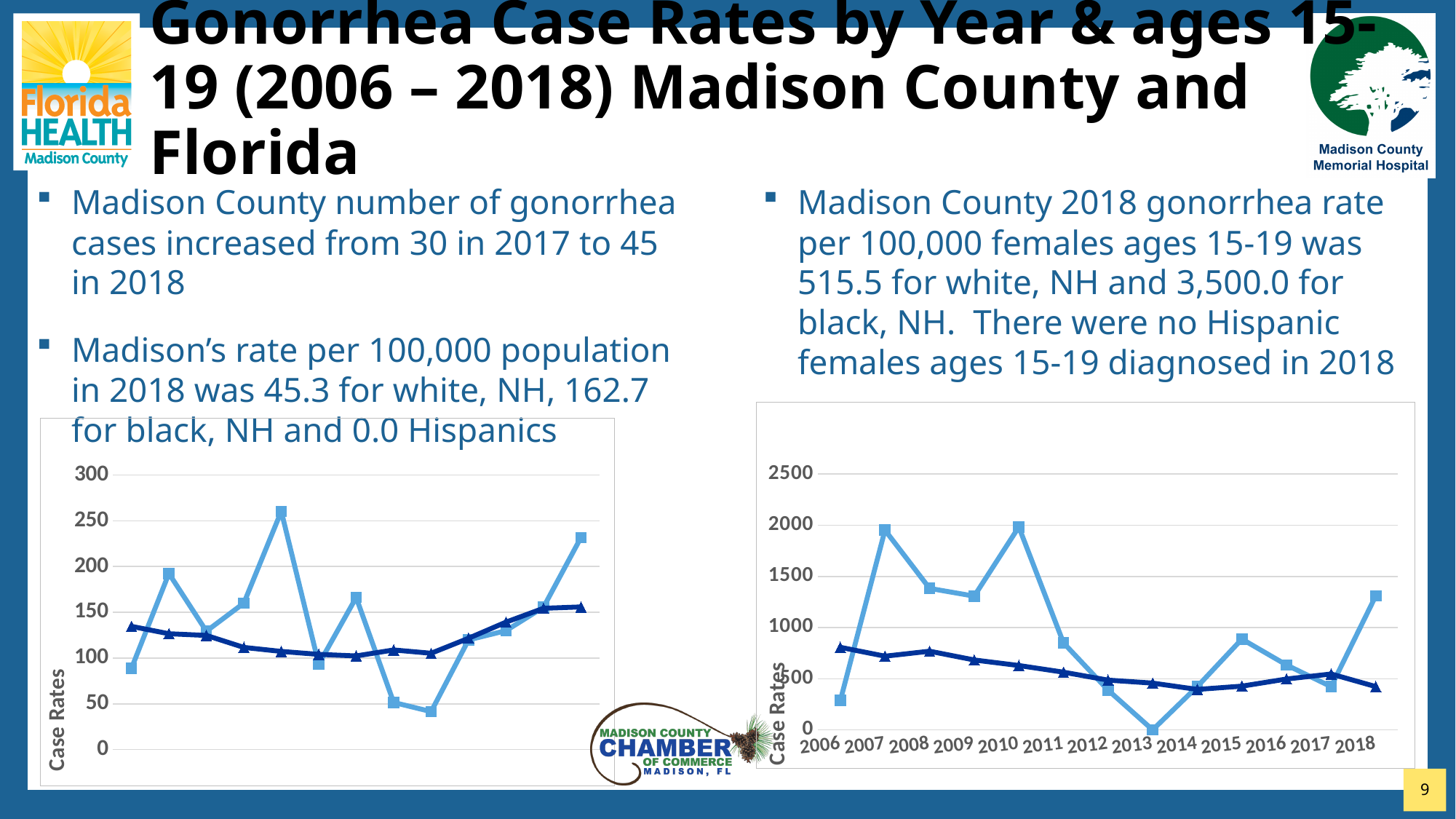
In the right chart, is the dark blue line's value for 2014 greater or less than 500? less In the right chart, does the dark blue line generally rise or fall from 2006 to 2014? fall In the right chart, is the light blue line's value for 2018 greater or less than 1000? greater In the right chart, how many years are shown on the x axis? 13 What kind of chart is the chart on the right side of the slide? line chart In the right chart, which year has the lowest value on the light blue line? 2013 What is the label on the vertical axis of the right chart? Case Rates In the right chart, which is larger on the dark blue line: the value for 2006 or the value for 2014? 2006 In the right chart, is the light blue line's value for 2006 greater or less than 500? less What kind of chart is the chart on the left side of the slide? line chart In the right chart, which is larger on the light blue line: the value for 2007 or the value for 2012? 2007